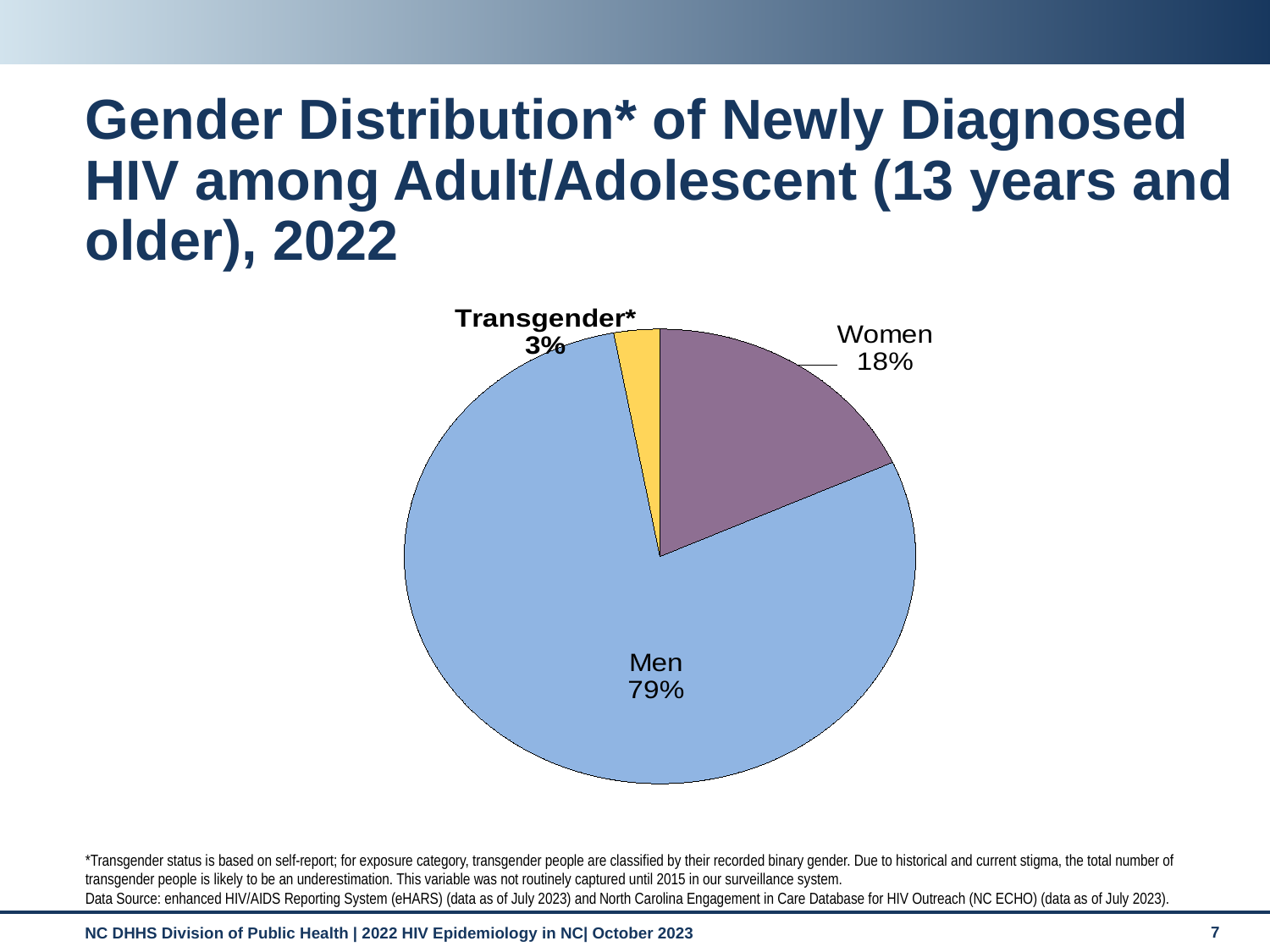
What colour is the Men slice of the pie? Light blue Which gender category has the largest share of the pie? Men What is the difference in percentage points between the Women and Transgender slices? 15 How many categories are shown in the pie chart? 3 What percentage of newly diagnosed HIV cases were among Men? 79% What type of chart is shown on the slide? Pie chart What percentage of newly diagnosed HIV cases were among Transgender people? 3% What is the difference in percentage points between the Men and Women slices? 61 What percentage of newly diagnosed HIV cases were among Women? 18% Which slice is larger, Women or Transgender? Women Which gender category has the smallest share of the pie? Transgender* What year does the chart title say the data is for? 2022